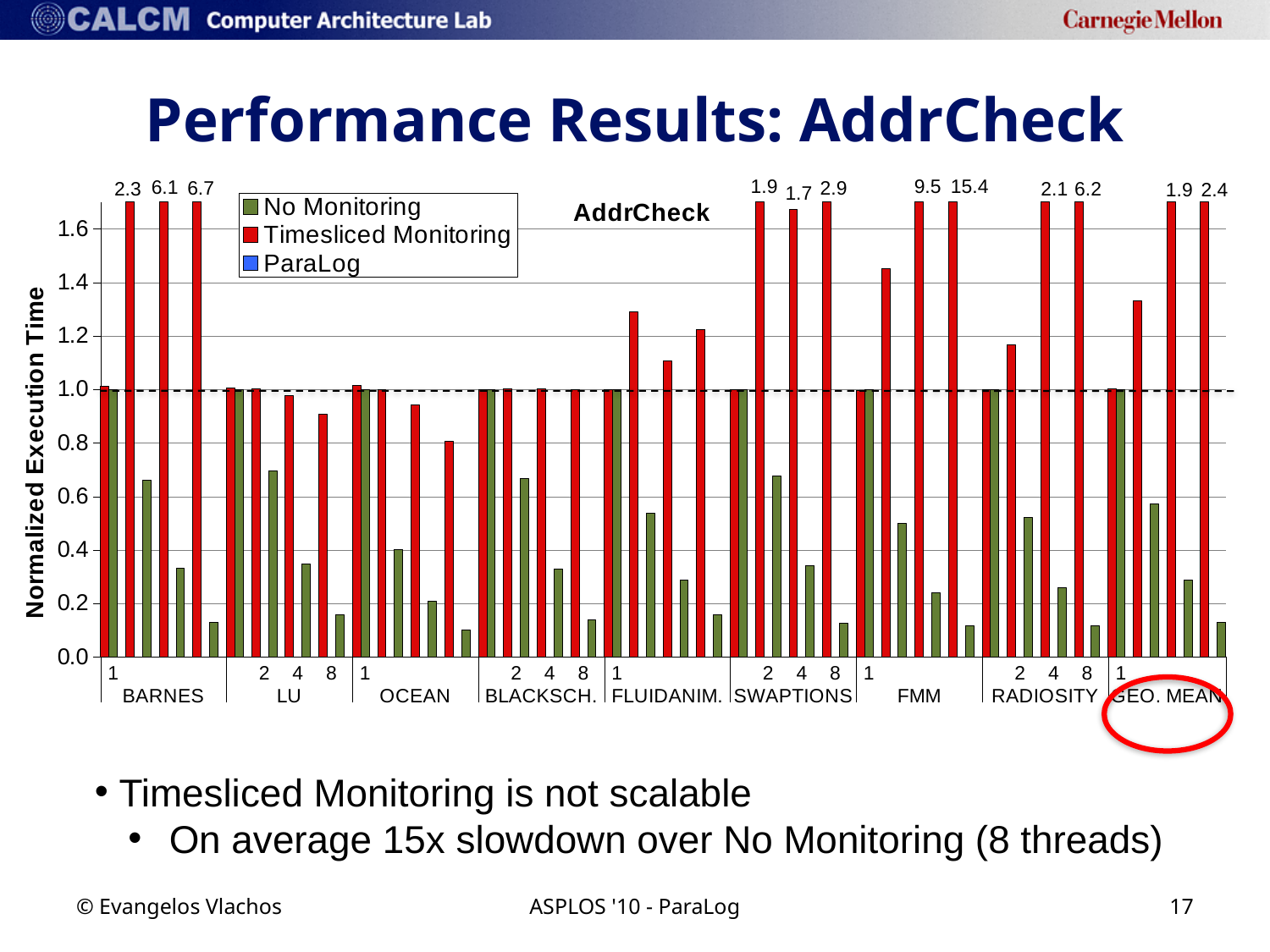
What is the difference between the Timesliced Monitoring values for FMM at 8 threads and at 4 threads? 5.9 Which is larger, the Timesliced Monitoring value for BARNES at 8 threads or for RADIOSITY at 8 threads? BARNES at 8 threads Within BARNES, do the No Monitoring bars rise or fall as the thread count increases from 1 to 8? fall What kind of chart is shown on the slide? bar chart What is the Timesliced Monitoring value for BARNES at 8 threads? 6.7 What is the Timesliced Monitoring value for FMM at 8 threads? 15.4 How many series does the legend list? 3 Is the Timesliced Monitoring value for OCEAN at 8 threads greater or less than 1.0? less Which benchmark and thread count has the highest Timesliced Monitoring value? FMM at 8 threads How many benchmark groups are shown along the x axis, including GEO. MEAN? 9 What is the Timesliced Monitoring value for SWAPTIONS at 4 threads? 1.7 What is the Timesliced Monitoring value for GEO. MEAN at 8 threads? 2.4